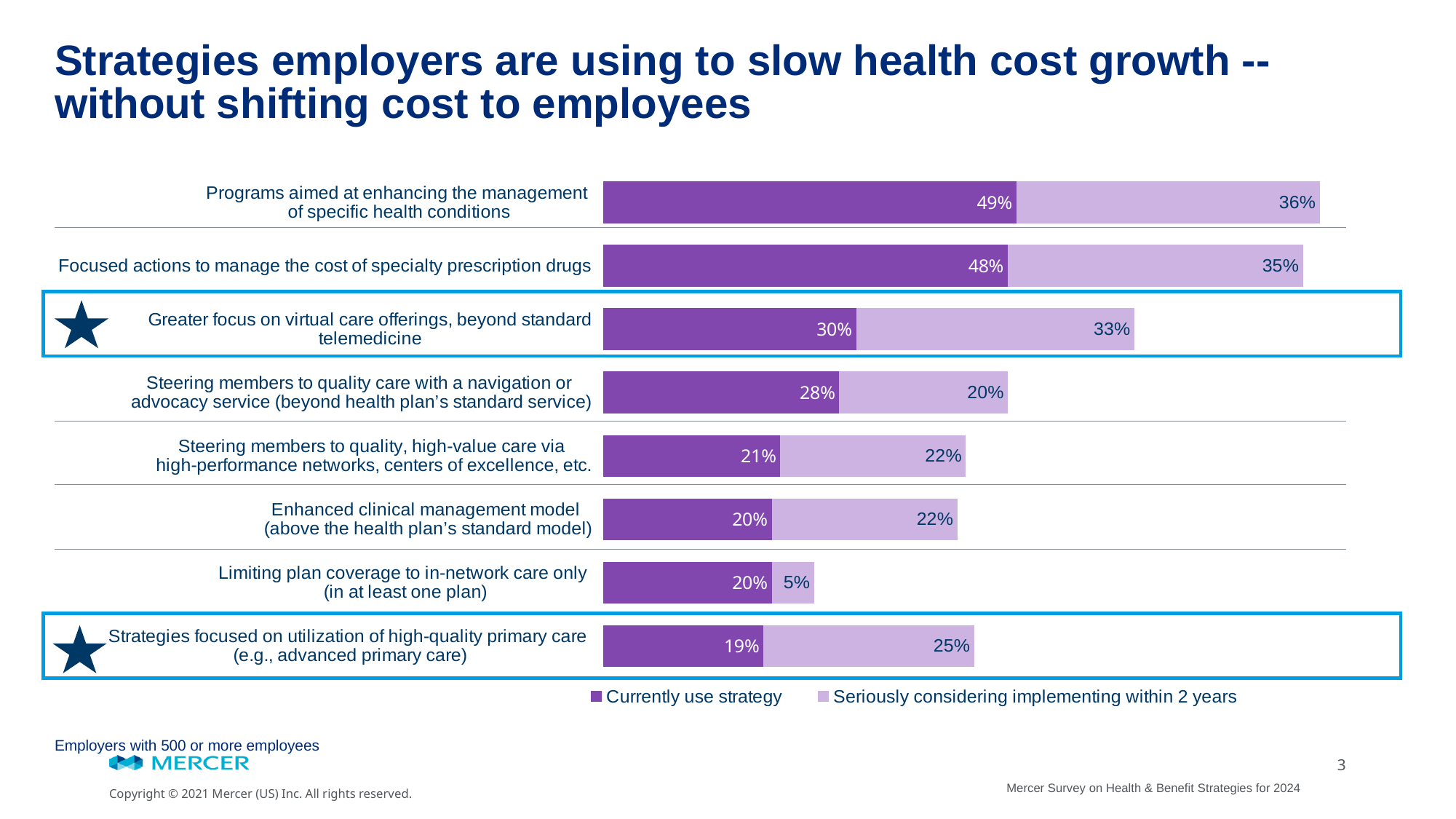
Which strategy has the lowest 'Seriously considering implementing within 2 years' value? Limiting plan coverage to in-network care only (in at least one plan) Which is larger: the 'Currently use strategy' value for steering members to quality care with a navigation or advocacy service, or the 'Currently use strategy' value for enhanced clinical management model? Steering members to quality care with a navigation or advocacy service What is the combined total of the two segments for the 'Limiting plan coverage to in-network care only' bar? 25% What percentage of employers currently use programs aimed at enhancing the management of specific health conditions? 49% What kind of chart is shown on the slide? Stacked bar chart What is the difference between the 'Currently use strategy' values for focused actions to manage the cost of specialty prescription drugs and for greater focus on virtual care offerings? 18% What percentage of employers are seriously considering implementing a greater focus on virtual care offerings, beyond standard telemedicine, within 2 years? 33% How many strategies are listed in the chart? 8 How many series does the legend list? 2 Which strategy has the highest 'Currently use strategy' value? Programs aimed at enhancing the management of specific health conditions What are the two series named in the legend? Currently use strategy; Seriously considering implementing within 2 years What percentage of employers currently use strategies focused on utilization of high-quality primary care? 19%